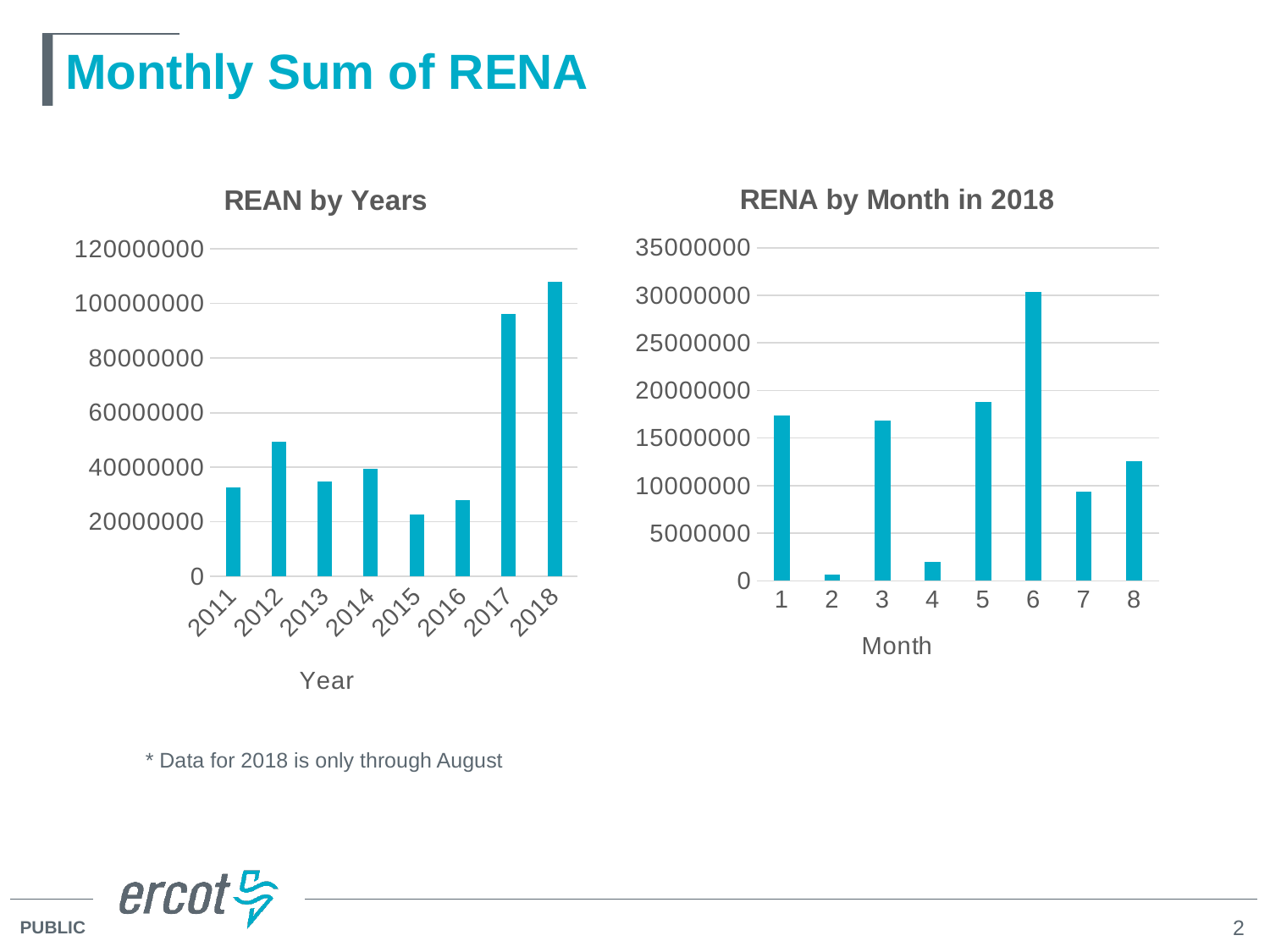
In the "RENA by Month in 2018" chart, is the value for month 7 greater or less than 10000000? less In the "RENA by Month in 2018" chart, which month has the lowest value? 2 In the "RENA by Month in 2018" chart, which month has the highest value? 6 In the "REAN by Years" chart, which is larger, the value for 2012 or the value for 2013? 2012 In the "REAN by Years" chart, which year has the highest value? 2018 In the "REAN by Years" chart, which year has the lowest value? 2015 In the "REAN by Years" chart, is the value for 2015 greater or less than 40000000? less In the "RENA by Month in 2018" chart, is the value for month 6 greater or less than 25000000? greater How many years are shown in the "REAN by Years" chart? 8 In the "RENA by Month in 2018" chart, which is larger, the value for month 8 or the value for month 7? month 8 What kind of chart is the "RENA by Month in 2018" chart? bar chart